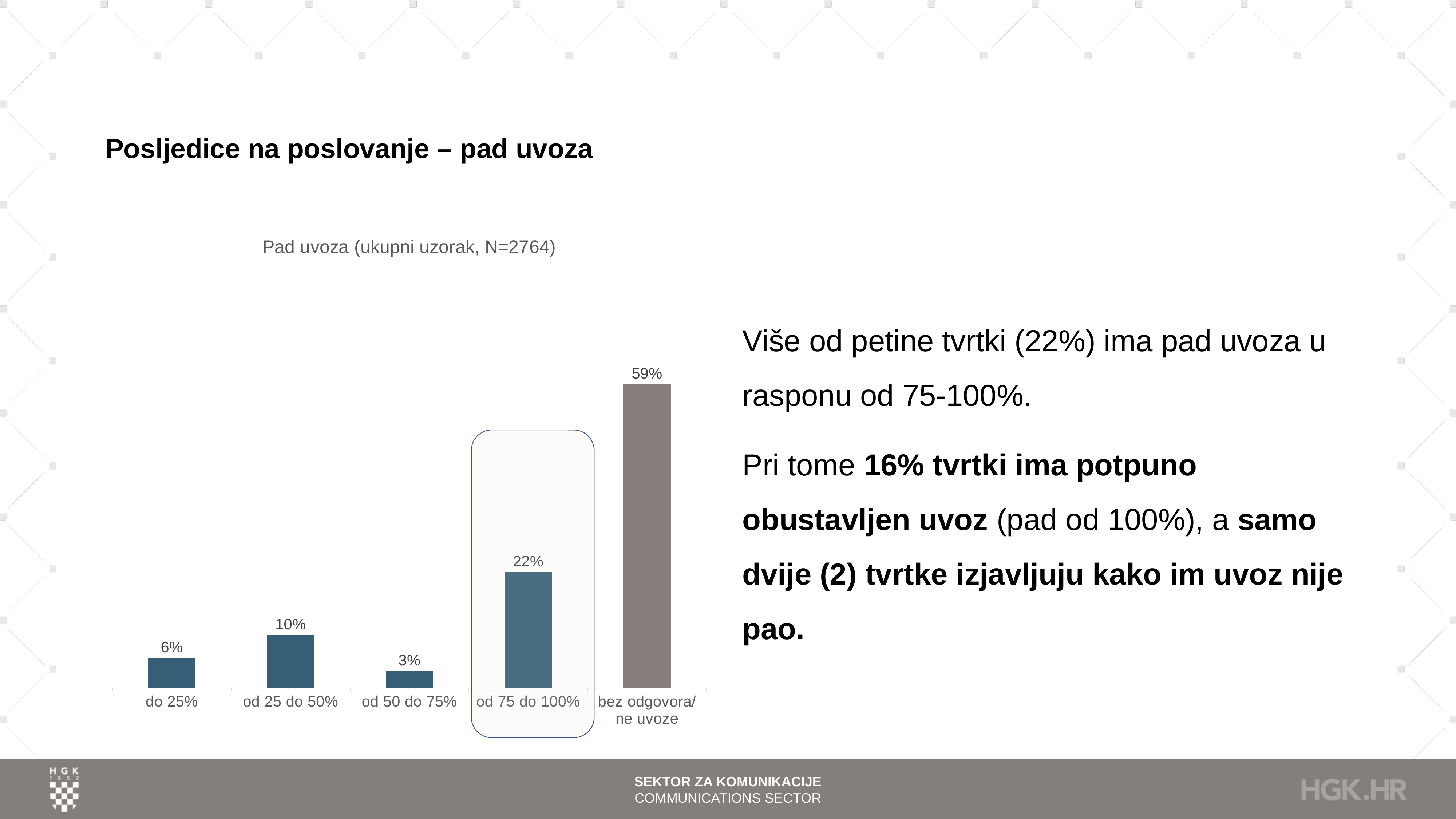
What is the title of the chart? Pad uvoza (ukupni uzorak, N=2764) What is the value for the 'od 50 do 75%' category? 3% What is the value for the 'bez odgovora/ ne uvoze' category? 59% What is the value for the 'od 75 do 100%' category? 22% Which is larger, the value for 'do 25%' or the value for 'od 25 do 50%'? od 25 do 50% What is the difference between the values for 'od 75 do 100%' and 'od 25 do 50%'? 12% What kind of chart is shown on the slide? bar chart Which category's bar is highlighted with a rounded outline? od 75 do 100% What is the value for the 'do 25%' category? 6% Which category has the lowest value? od 50 do 75% Which category has the highest value? bez odgovora/ ne uvoze How many categories are shown on the x axis? 5